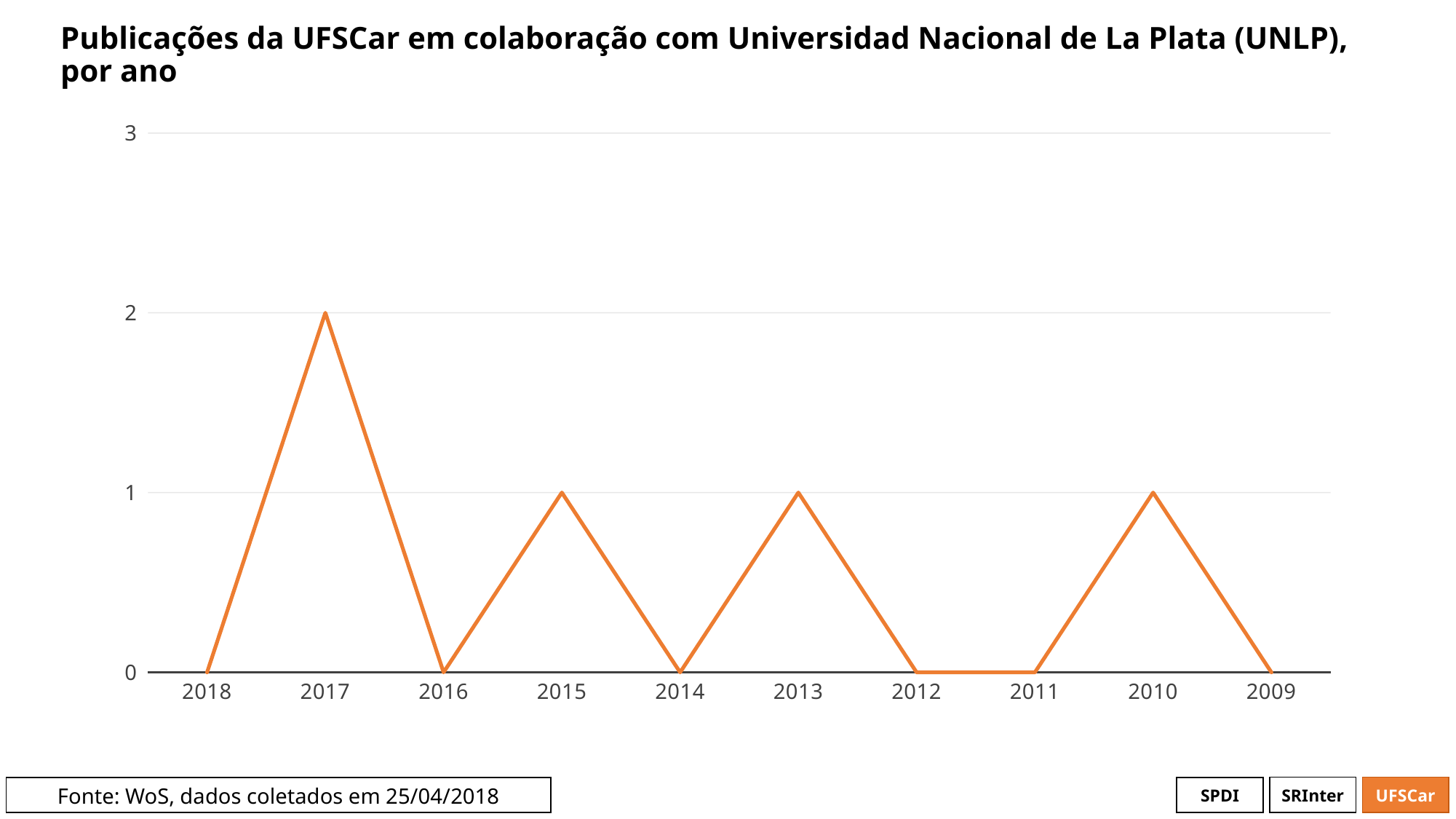
What is the title of the chart? Publicações da UFSCar em colaboração com Universidad Nacional de La Plata (UNLP), por ano How many years are shown on the x axis? 10 What is the value for 2018? 0 Which is larger, the value for 2017 or the value for 2010? 2017 What is the value for 2010? 1 What is the value for 2017? 2 What is the value for 2011? 0 What kind of chart is shown on the slide? line chart What is the difference between the values for 2017 and 2013? 1 Is the value for 2017 greater or less than 1? greater What is the value for 2015? 1 Which year has the highest value? 2017